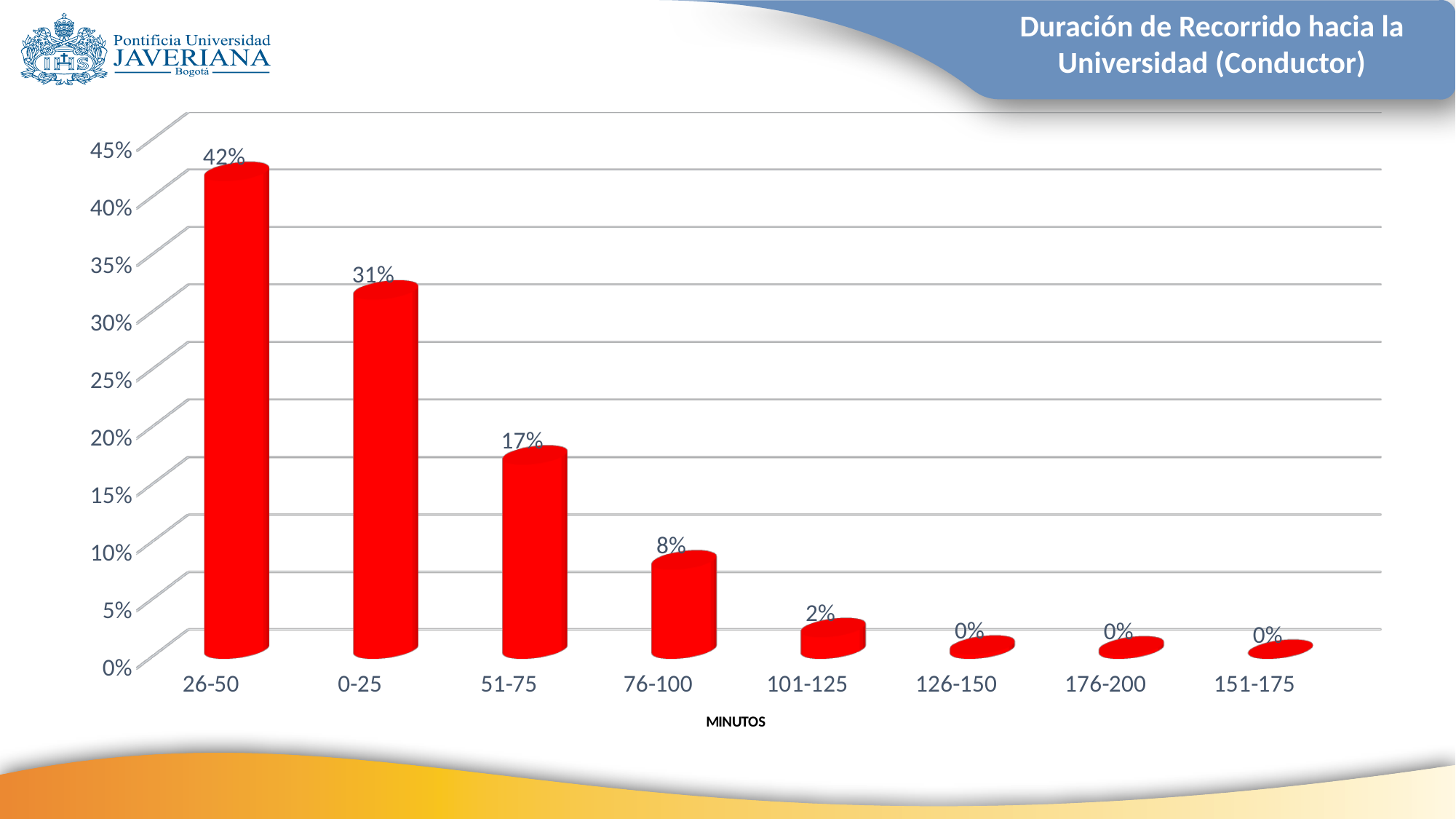
Which category has the highest value? 26-50 What is the label of the x axis? MINUTOS What is the value for the 0-25 minutes category? 31% What kind of chart is shown on the slide? bar chart What is the value for the 101-125 minutes category? 2% What is the value for the 51-75 minutes category? 17% Is the value for 76-100 greater or less than 10%? less What is the difference between the values for 51-75 and 76-100? 9% How many categories are shown on the x axis? 8 What is the value for the 26-50 minutes category? 42% Which is larger, the value for 0-25 or the value for 51-75? 0-25 What is the difference between the values for 26-50 and 0-25? 11%